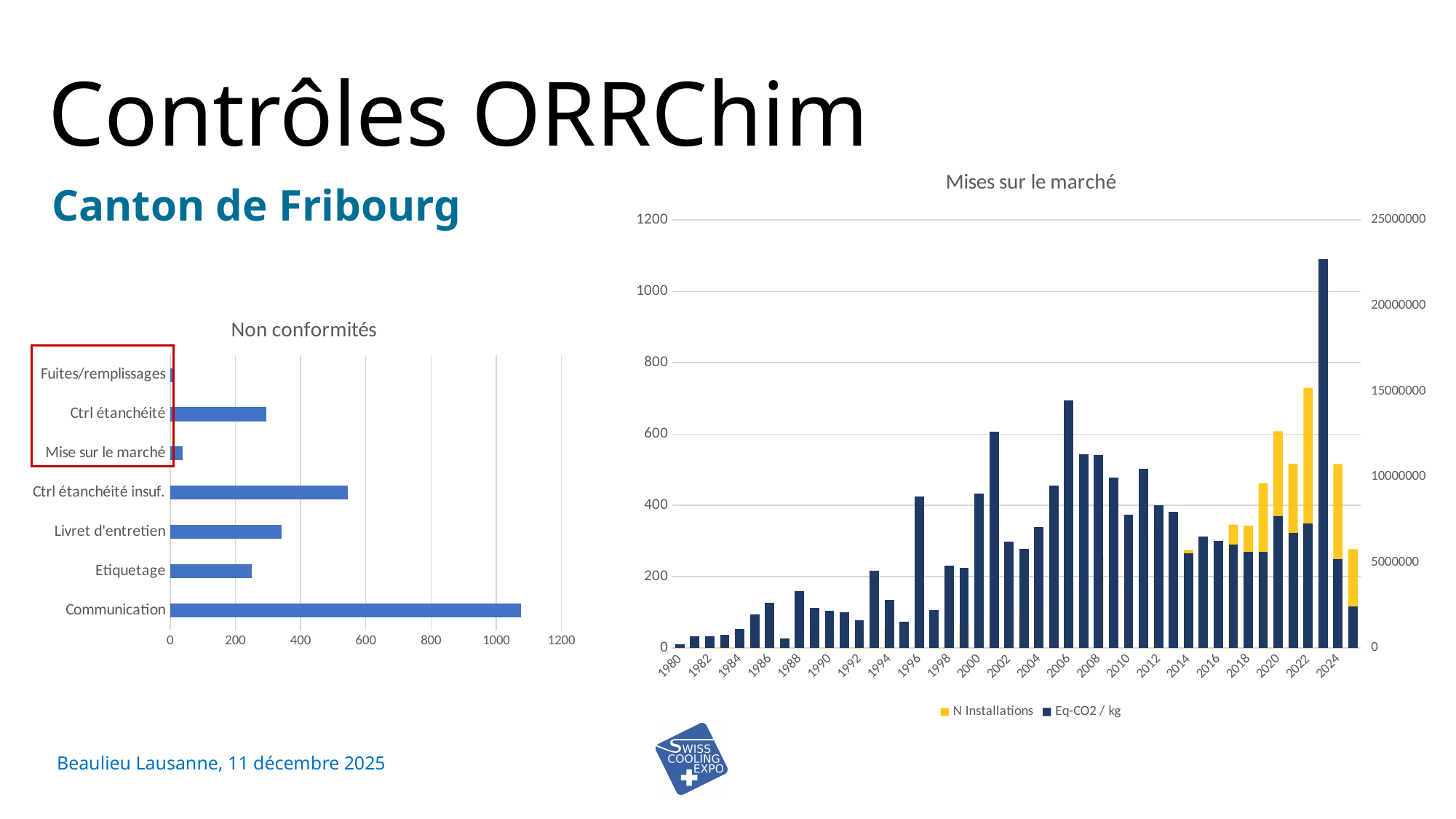
In the "Non conformités" chart, is the value for Mise sur le marché greater or less than 200? less What type of chart is the "Non conformités" chart? bar chart In the "Mises sur le marché" chart, which year has the tallest Eq-CO2 / kg bar? 2023 In the "Mises sur le marché" chart, which colour represents the N Installations series? yellow In the "Mises sur le marché" chart, is the Eq-CO2 / kg value for 2023 greater or less than 1000 on the left axis? greater In the "Non conformités" chart, which category has the lowest value? Fuites/remplissages In the "Non conformités" chart, is the value for Ctrl étanchéité insuf. greater or less than 400? greater In the "Non conformités" chart, which category has the highest value? Communication How many series does the legend of the "Mises sur le marché" chart list? 2 How many categories are shown in the "Non conformités" chart? 7 In the "Non conformités" chart, which is larger: Ctrl étanchéité insuf. or Livret d'entretien? Ctrl étanchéité insuf.